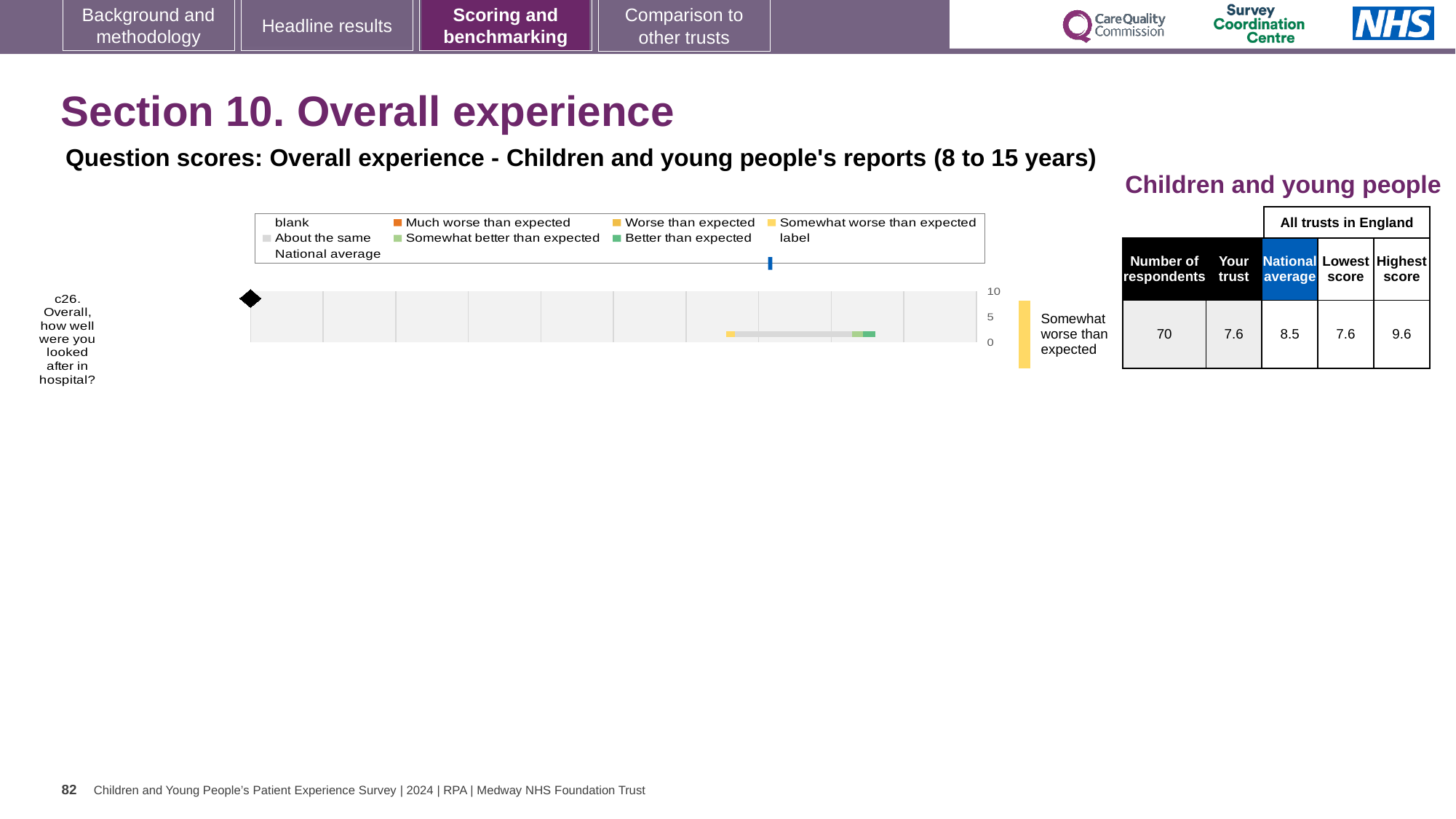
In the table beside the chart, what is the highest score among all trusts in England for question c26? 9.6 In the table beside the chart, what is the national average score for question c26? 8.5 What is the highest value shown on the chart's axis? 10 Which question is plotted on the chart? c26. Overall, how well were you looked after in hospital? In the table beside the chart, what is the lowest score among all trusts in England for question c26? 7.6 What is the difference between the national average (8.5) and the 'Your trust' score (7.6) for question c26? 0.9 In the table beside the chart, how many respondents answered question c26? 70 What kind of chart is shown on the slide for question c26? bar chart Which is larger for question c26: the 'Your trust' score or the national average? National average How many survey questions are plotted on the chart? 1 In the table beside the chart, what is the 'Your trust' score for question c26? 7.6 What rating label is shown to the right of the chart for question c26? Somewhat worse than expected